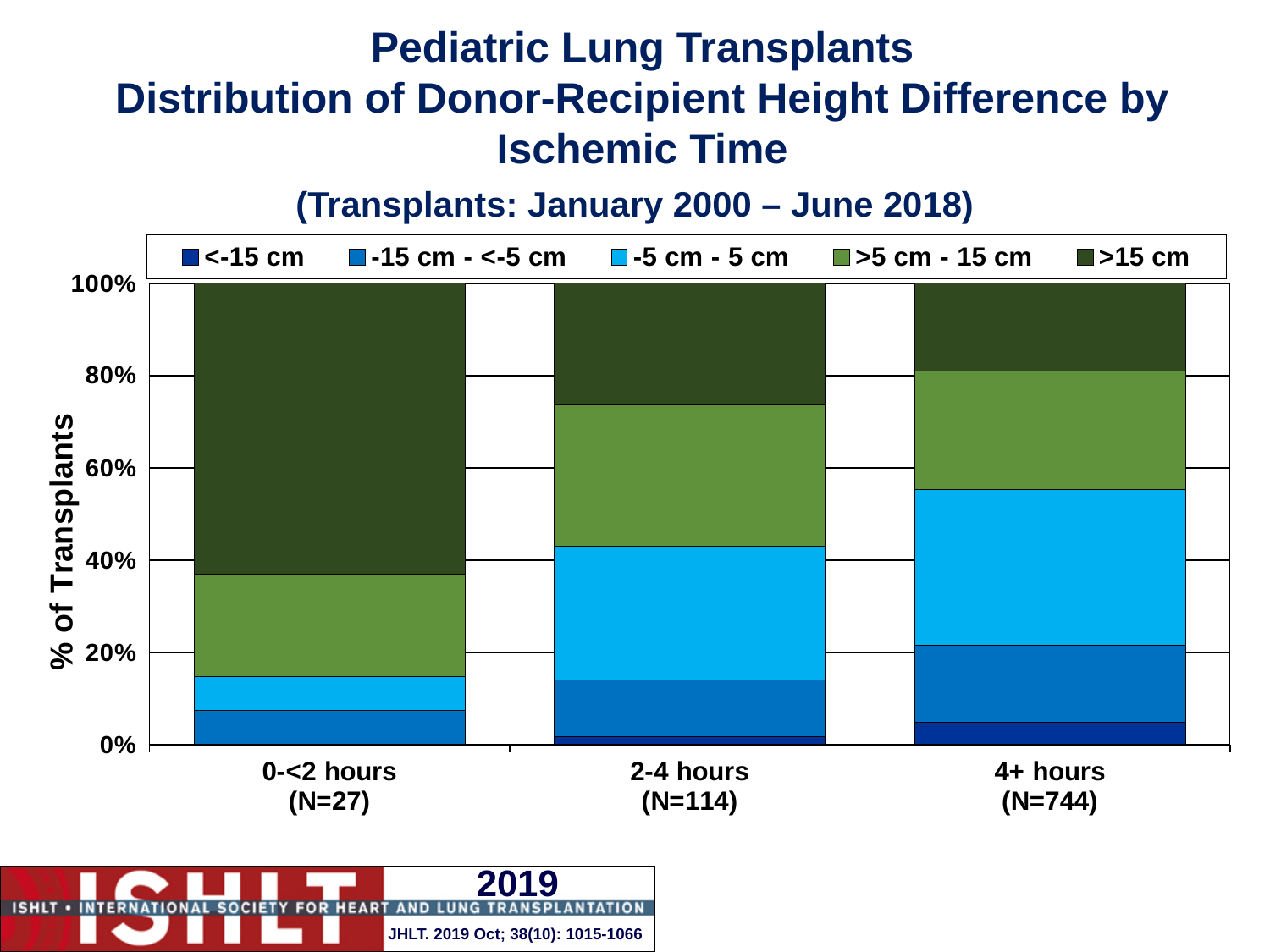
How many series does the legend list? 5 How many ischemic time categories are shown on the x axis? 3 Does the >15 cm share rise or fall from 0-<2 hours to 4+ hours? fall Is the -15 cm - <-5 cm share for 0-<2 hours greater or less than 20%? less What is the label on the y axis? % of Transplants Which ischemic time category has the largest >15 cm share? 0-<2 hours Is the -5 cm - 5 cm share larger for 0-<2 hours or for 2-4 hours? 2-4 hours What kind of chart is shown on the slide? Stacked bar chart Is the -5 cm - 5 cm share for 4+ hours greater or less than 20%? greater What is the N shown for the 4+ hours category? N=744 Is the >15 cm share for 0-<2 hours greater or less than 40%? greater Which ischemic time category has the smallest <-15 cm share? 0-<2 hours